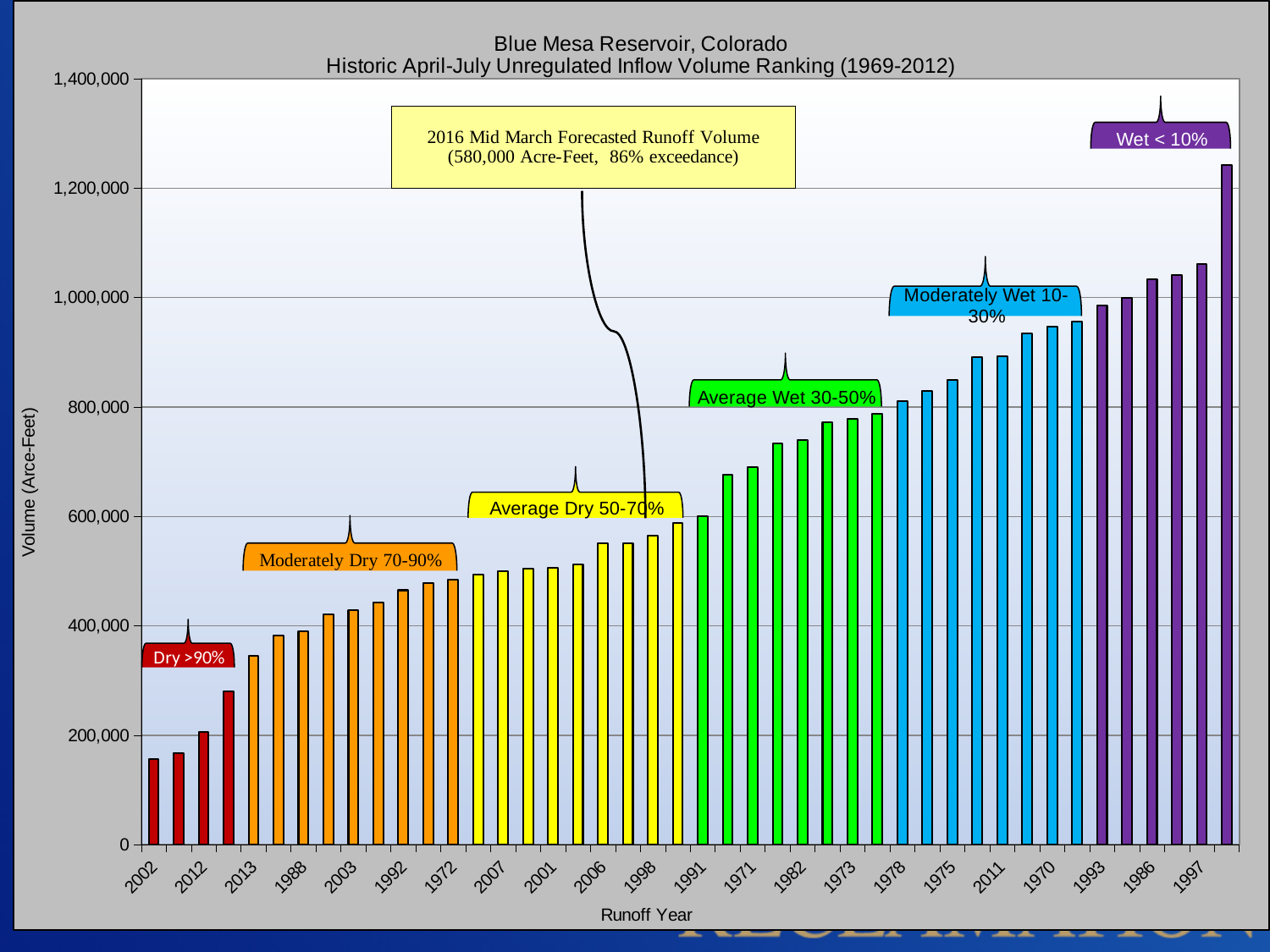
What is the title of the chart? Blue Mesa Reservoir, Colorado Historic April-July Unregulated Inflow Volume Ranking (1969-2012) Do the bar values rise or fall moving from left to right along the x axis? rise What kind of chart is shown on the slide? bar chart Is the value for 2002 greater or less than 200,000? less Is the value for 2013 greater or less than 400,000? less Is the value for 1982 greater or less than 600,000? greater What exceedance percentage is given for the 2016 Mid March forecasted runoff volume? 86% What is the 2016 Mid March forecasted runoff volume shown in the callout box? 580,000 Acre-Feet Which wetness category label is attached to the purple bars at the right of the chart? Wet < 10% Which runoff year has the lowest inflow volume on the chart? 2002 Which has the larger inflow volume, 1982 or 2003? 1982